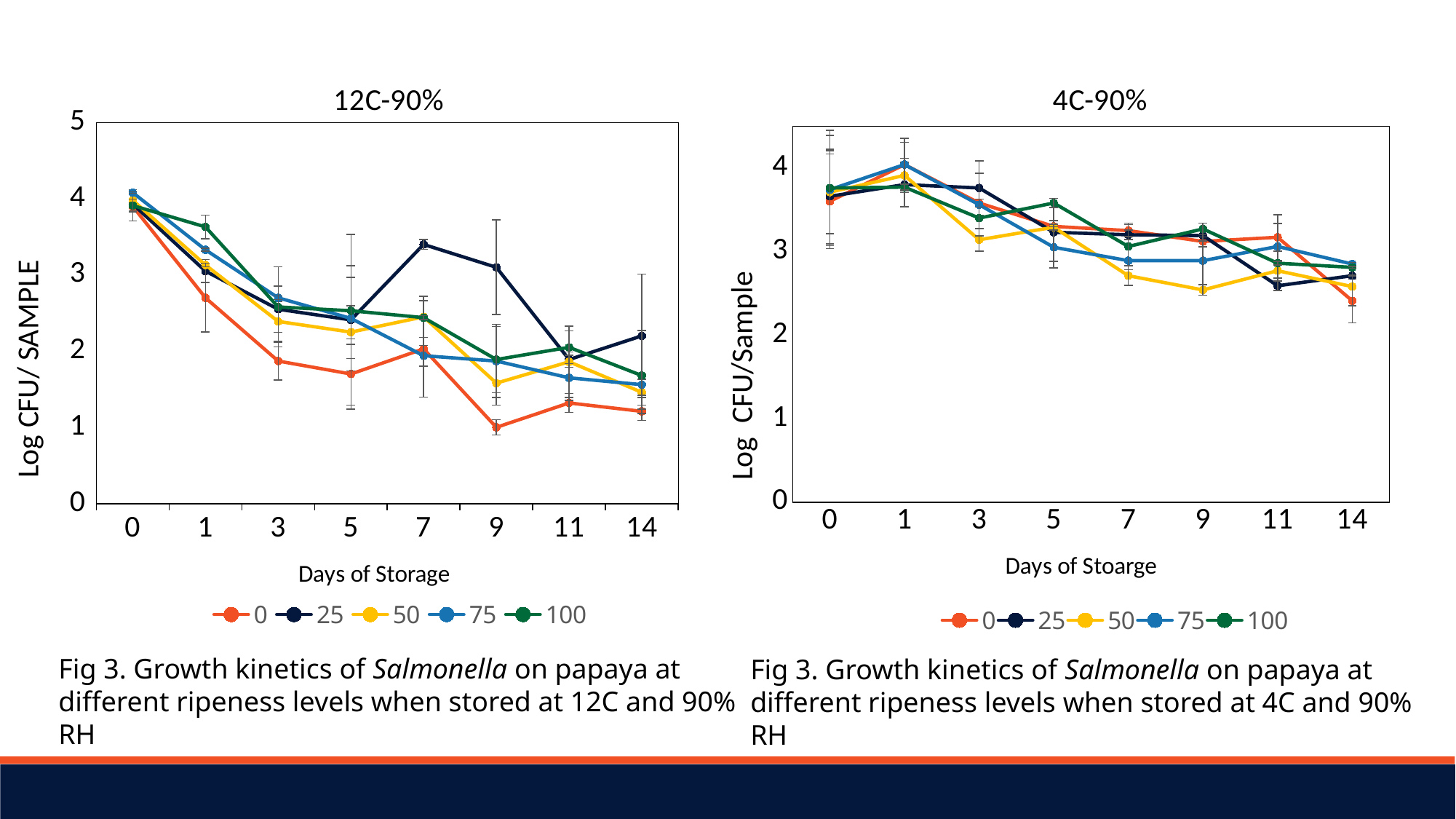
In the 12C-90% chart, do the values for series 0 generally rise or fall as days of storage increase? fall In the 12C-90% chart, which series has the lowest value at day 9? 0 In the 12C-90% chart, is the value for series 25 at day 7 greater or less than 3? greater How many days of storage are plotted on the x axis of the 12C-90% chart? 8 In the 4C-90% chart, which is larger at day 5: the value for series 100 or the value for series 75? 100 In the 4C-90% chart, which series has the lowest value at day 9? 50 In the 12C-90% chart, which series has the highest value at day 7? 25 In the 4C-90% chart, is the value for series 0 at day 14 greater or less than 3? less What is the x-axis label of the 12C-90% chart? Days of Storage How many series does the legend of the 4C-90% chart list? 5 What kind of chart is the 12C-90% chart? line chart In the 12C-90% chart, is the value for series 0 at day 3 greater or less than 2? less